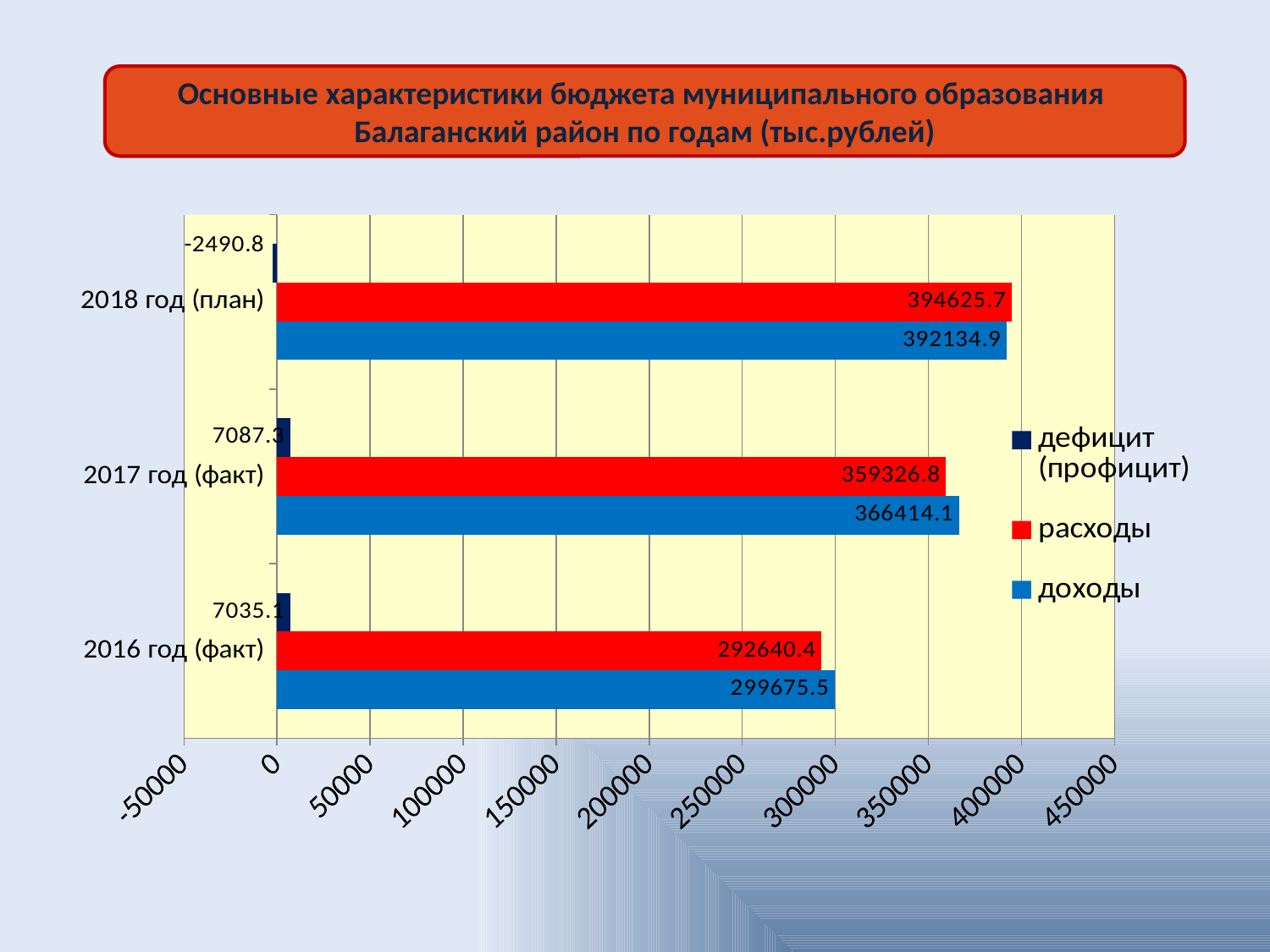
What is the value of дефицит (профицит) for 2018 год (план)? -2490.8 Which year has the highest value of расходы? 2018 год (план) What kind of chart is shown on the slide? bar chart How many year categories are shown on the chart? 3 What is the value of дефицит (профицит) for 2017 год (факт)? 7087.3 What is the difference between доходы for 2017 год (факт) and 2016 год (факт)? 66738.6 Which year has the lowest value of доходы? 2016 год (факт) How many series does the legend list? 3 What is the value of расходы for 2018 год (план)? 394625.7 Which is larger for 2018 год (план): доходы or расходы? расходы What is the value of доходы for 2016 год (факт)? 299675.5 What is the difference between расходы for 2018 год (план) and 2017 год (факт)? 35298.9